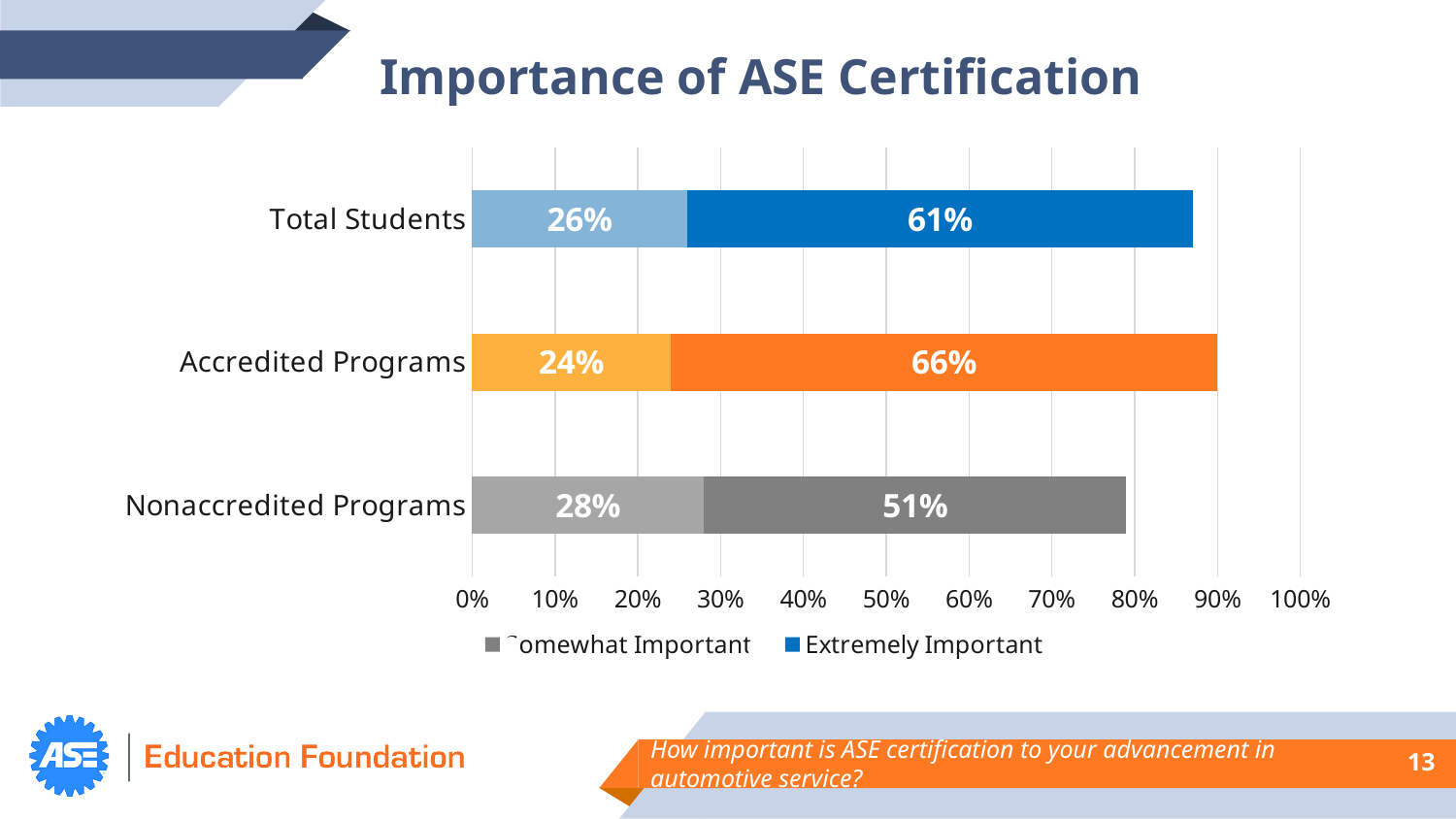
What is the combined total of the Somewhat Important and Extremely Important values for Total Students? 87% How many series does the legend list? 2 Which category has the lowest Somewhat Important value? Accredited Programs What is the Extremely Important value for Accredited Programs? 66% What is the combined total of the two segments for Nonaccredited Programs? 79% What percentage of Total Students rated ASE certification as Extremely Important? 61% What is the difference between the Extremely Important values for Accredited Programs and Nonaccredited Programs? 15% How many categories are shown on the chart? 3 Which category has the highest Extremely Important value? Accredited Programs Which is larger: the Somewhat Important value for Total Students or for Nonaccredited Programs? Nonaccredited Programs What is the Somewhat Important value for Nonaccredited Programs? 28% What type of chart is shown on the slide? Stacked bar chart